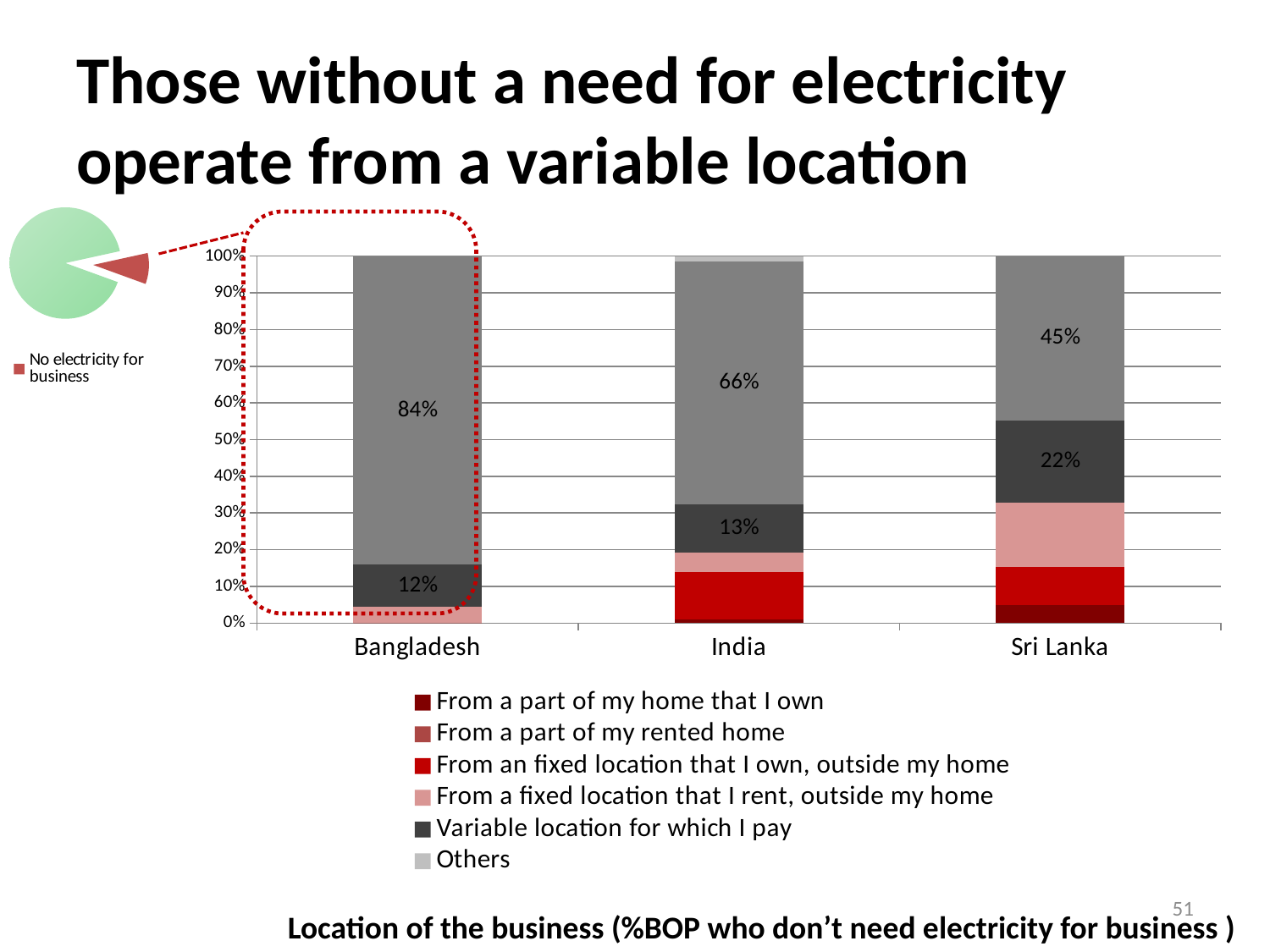
In the stacked bar chart, what is the value labeled on the dark grey segment of the Bangladesh bar? 12% In the stacked bar chart, what is the value labeled on the largest segment of the Sri Lanka bar? 45% Which country has the highest value for its largest labeled segment in the stacked bar chart? Bangladesh Which is larger: the dark grey segment for Sri Lanka or the dark grey segment for India? Sri Lanka What kind of chart is the main chart on the slide? Stacked bar chart What is the difference between the largest labeled segment for Bangladesh and the largest labeled segment for Sri Lanka? 39 percentage points How many countries are shown on the x axis of the stacked bar chart? 3 In the stacked bar chart, what is the value labeled on the dark grey segment of the Sri Lanka bar? 22% How many entries does the legend of the stacked bar chart list? 6 In the stacked bar chart, what is the value labeled on the largest segment of the India bar? 66% In the stacked bar chart, what is the value labeled on the dark grey segment of the India bar? 13% In the stacked bar chart, what is the value labeled on the largest segment of the Bangladesh bar? 84%